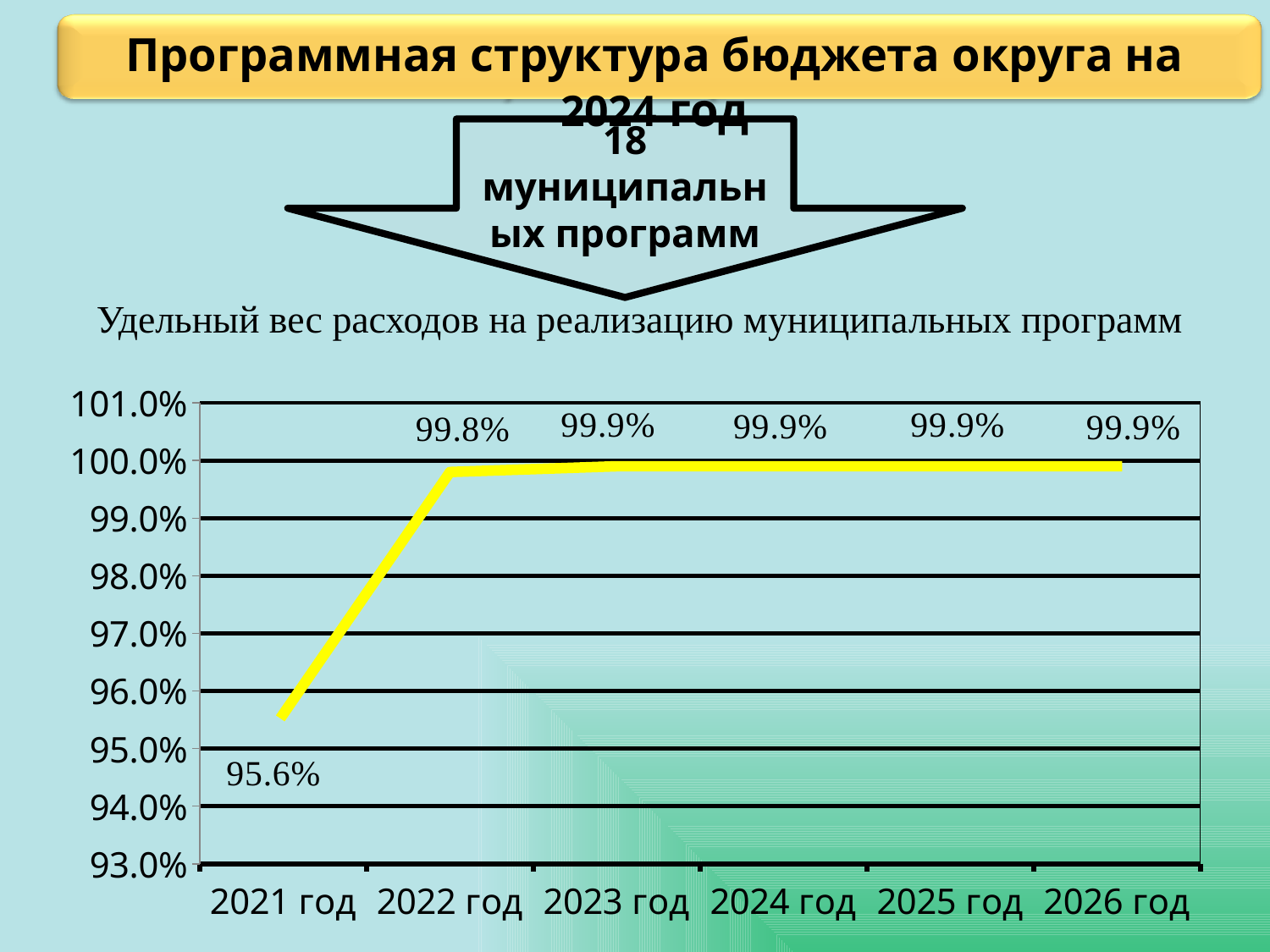
Is the value for 2021 год greater or less than 96.0%? less What is the difference between the values for 2022 год and 2021 год? 4.2% Which year has the lowest value? 2021 год What kind of chart is shown? line chart What is the title of the chart? Удельный вес расходов на реализацию муниципальных программ What is the difference between the values for 2023 год and 2022 год? 0.1% What is the value for 2021 год? 95.6% How many years are plotted on the x axis? 6 What is the value for 2022 год? 99.8% What is the value for 2026 год? 99.9% What is the value for 2024 год? 99.9% Which is larger, the value for 2021 год or the value for 2022 год? 2022 год